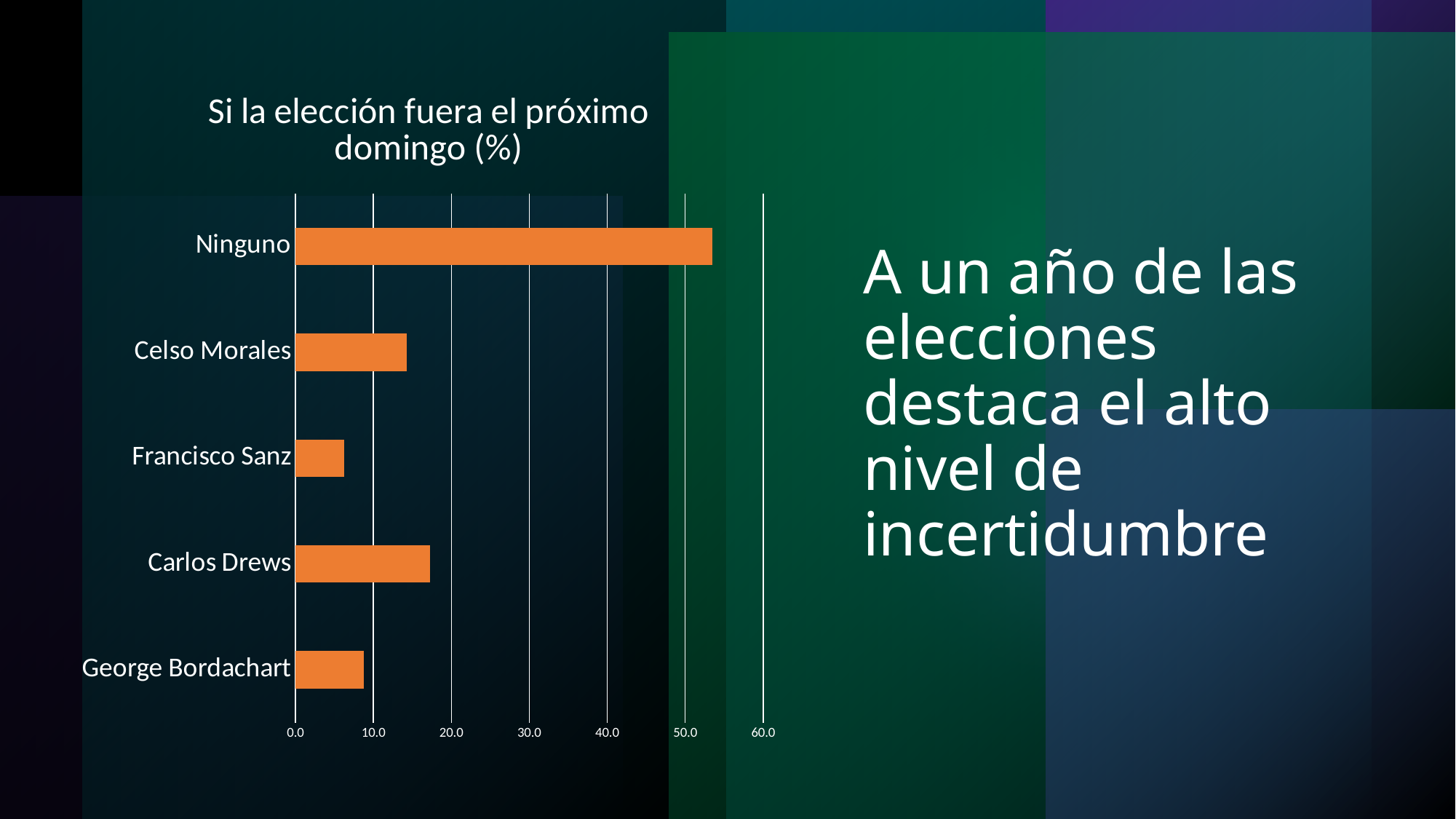
Which category has the highest value in the chart? Ninguno What is the title of the chart? Si la elección fuera el próximo domingo (%) Is the value for Celso Morales greater or less than 10.0? greater Is the value for Francisco Sanz greater or less than 10.0? less What kind of chart is shown on the slide? bar chart Which is larger, the value for George Bordachart or the value for Francisco Sanz? George Bordachart Which is larger, the value for Carlos Drews or the value for Celso Morales? Carlos Drews What colour are the bars in the chart? orange Which category has the lowest value in the chart? Francisco Sanz Is the value for Ninguno greater or less than 50.0? greater How many categories are plotted in the chart? 5